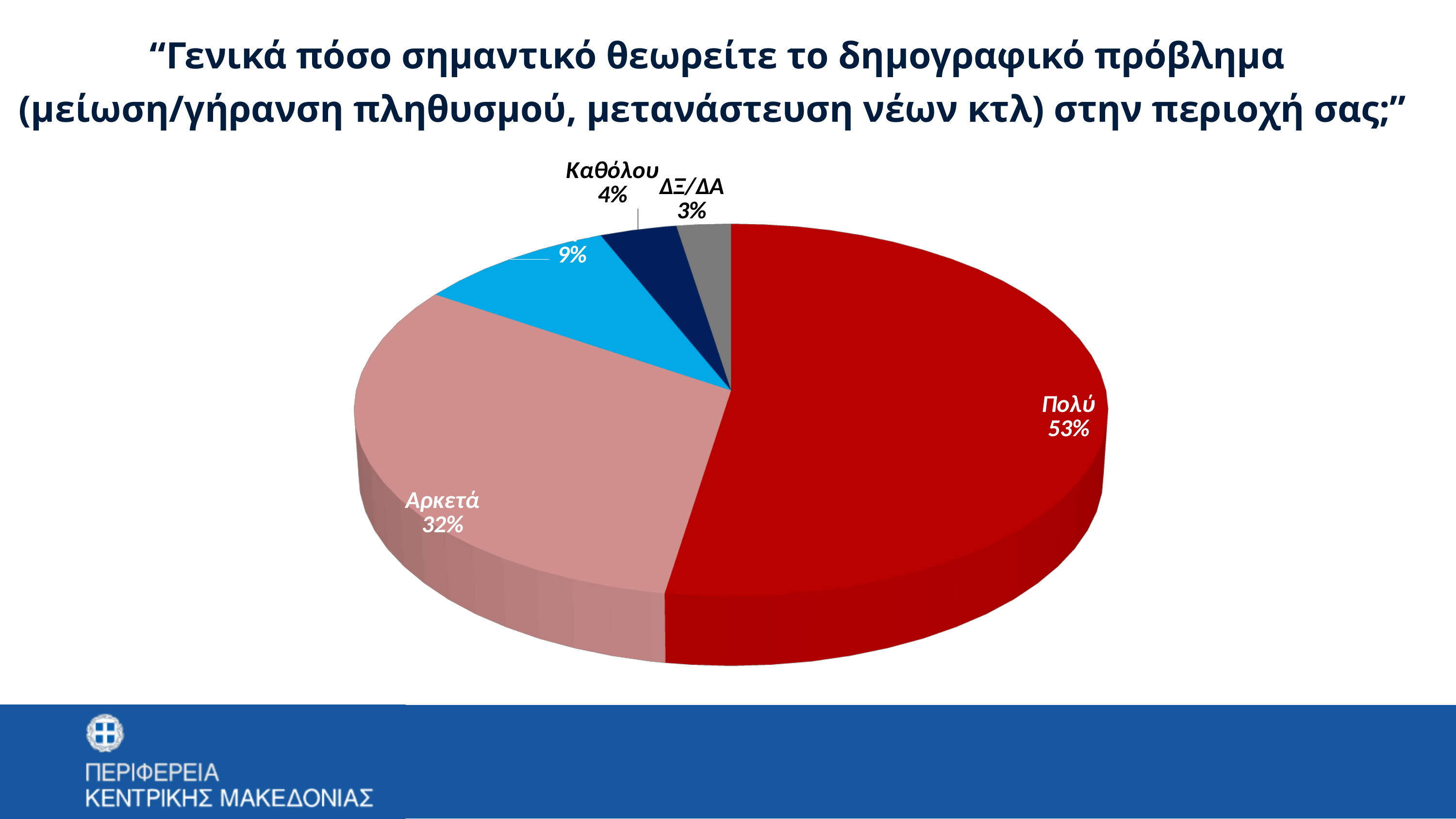
What percentage is shown for "ΔΞ/ΔΑ"? 3% What is the difference in percentage points between "Πολύ" and "Αρκετά"? 21 Which response has the smallest share of the pie? ΔΞ/ΔΑ What kind of chart is shown on the slide? Pie chart What percentage of respondents answered "Πολύ"? 53% What percentage of respondents answered "Καθόλου"? 4% What percentage of respondents answered "Αρκετά"? 32% Which response has the largest share of the pie? Πολύ What colour is the slice for "Πολύ"? Red Which is larger, the share for "Καθόλου" or the share for "ΔΞ/ΔΑ"? Καθόλου What is the combined share of "Πολύ" and "Αρκετά"? 85% How many slices does the pie chart have? 5